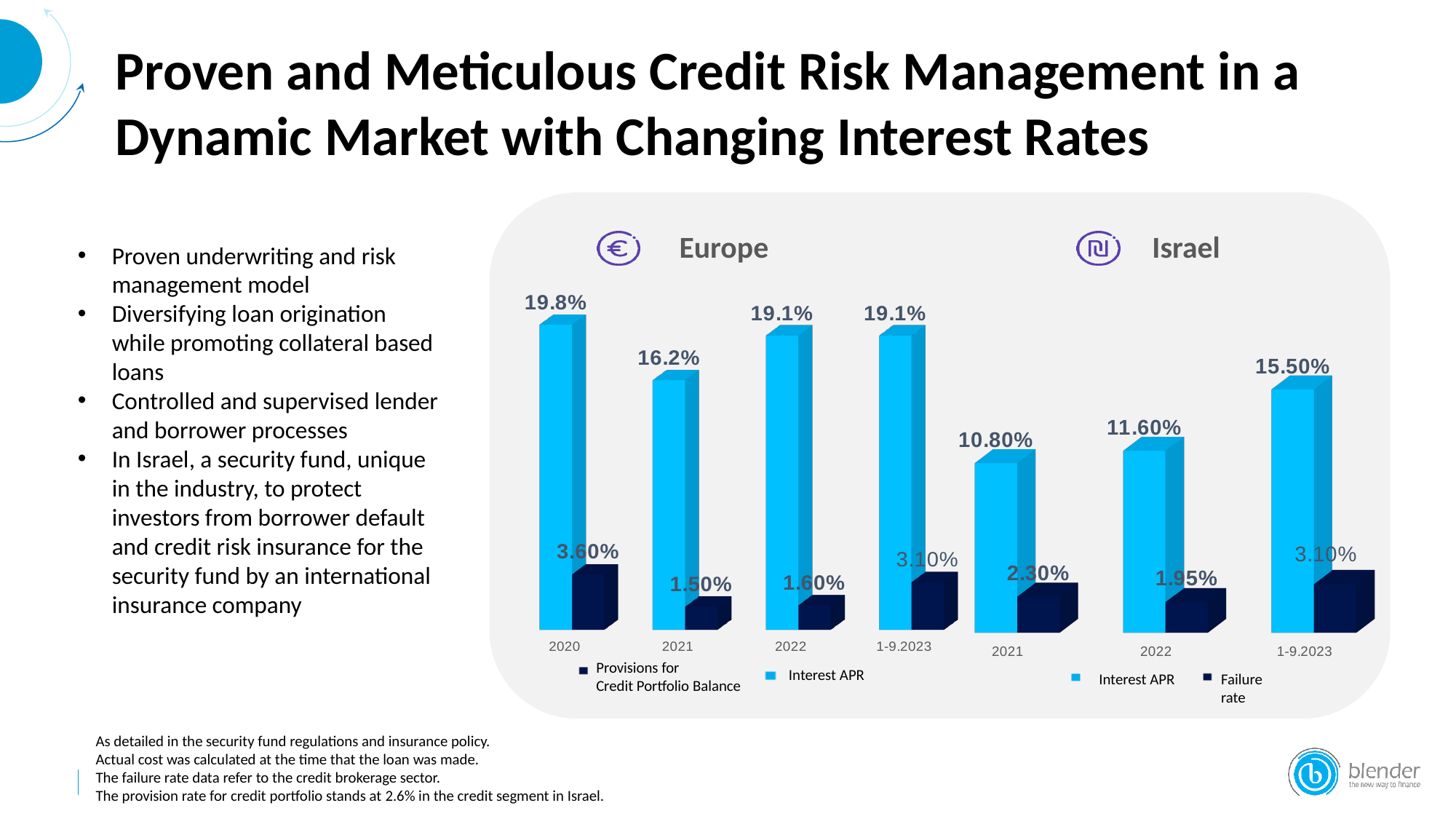
In the Europe chart, which period has the lowest Provisions for Credit Portfolio Balance? 2021 In the Europe chart, what is the difference between the Interest APR for 2020 and 2021? 3.6% In the Europe chart, what is the Interest APR for 2020? 19.8% In the Israel chart, does the Interest APR rise or fall from 2021 to 1-9.2023? rise In the Israel chart, which period has the lowest Interest APR? 2021 In the Israel chart, what is the Interest APR for 1-9.2023? 15.50% In the Israel chart, what is the Failure rate for 2022? 1.95% How many periods are shown on the x axis of the Israel chart? 3 In the Europe chart, what is the Provisions for Credit Portfolio Balance value for 2021? 1.50% How many series does the legend of the Europe chart list? 2 In the Israel chart, is the Failure rate for 1-9.2023 larger or smaller than the Failure rate for 2021? larger In the Europe chart, which year has the highest Interest APR? 2020